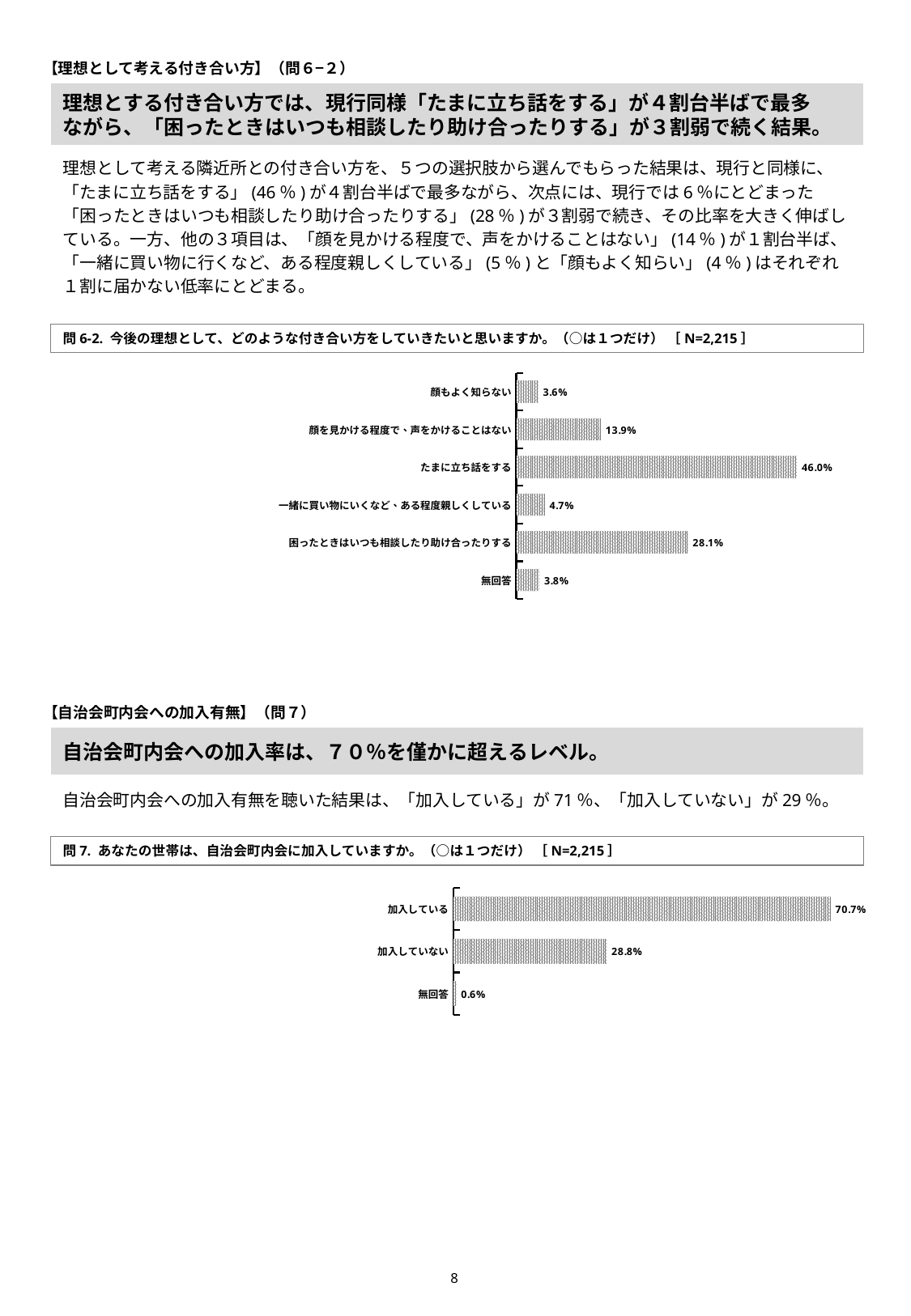
In the 問 7 chart (bottom), what is the value for 加入している? 70.7% In the 問 6-2 chart (top), which is larger: 顔を見かける程度で、声をかけることはない or 一緒に買い物にいくなど、ある程度親しくしている? 顔を見かける程度で、声をかけることはない In the 問 7 chart (bottom), what is the difference between 加入している and 加入していない? 41.9% In the 問 7 chart (bottom), what is the value for 無回答? 0.6% What kind of chart is the 問 6-2 chart (top)? bar chart In the 問 7 chart (bottom), how many categories are shown? 3 In the 問 6-2 chart (top), what is the value for たまに立ち話をする? 46.0% In the 問 6-2 chart (top), which category has the lowest value? 顔もよく知らない In the 問 6-2 chart (top), how many categories are shown? 6 In the 問 6-2 chart (top), what is the value for 困ったときはいつも相談したり助け合ったりする? 28.1% In the 問 6-2 chart (top), what is the difference between たまに立ち話をする and 困ったときはいつも相談したり助け合ったりする? 17.9% In the 問 6-2 chart (top), which category has the highest value? たまに立ち話をする